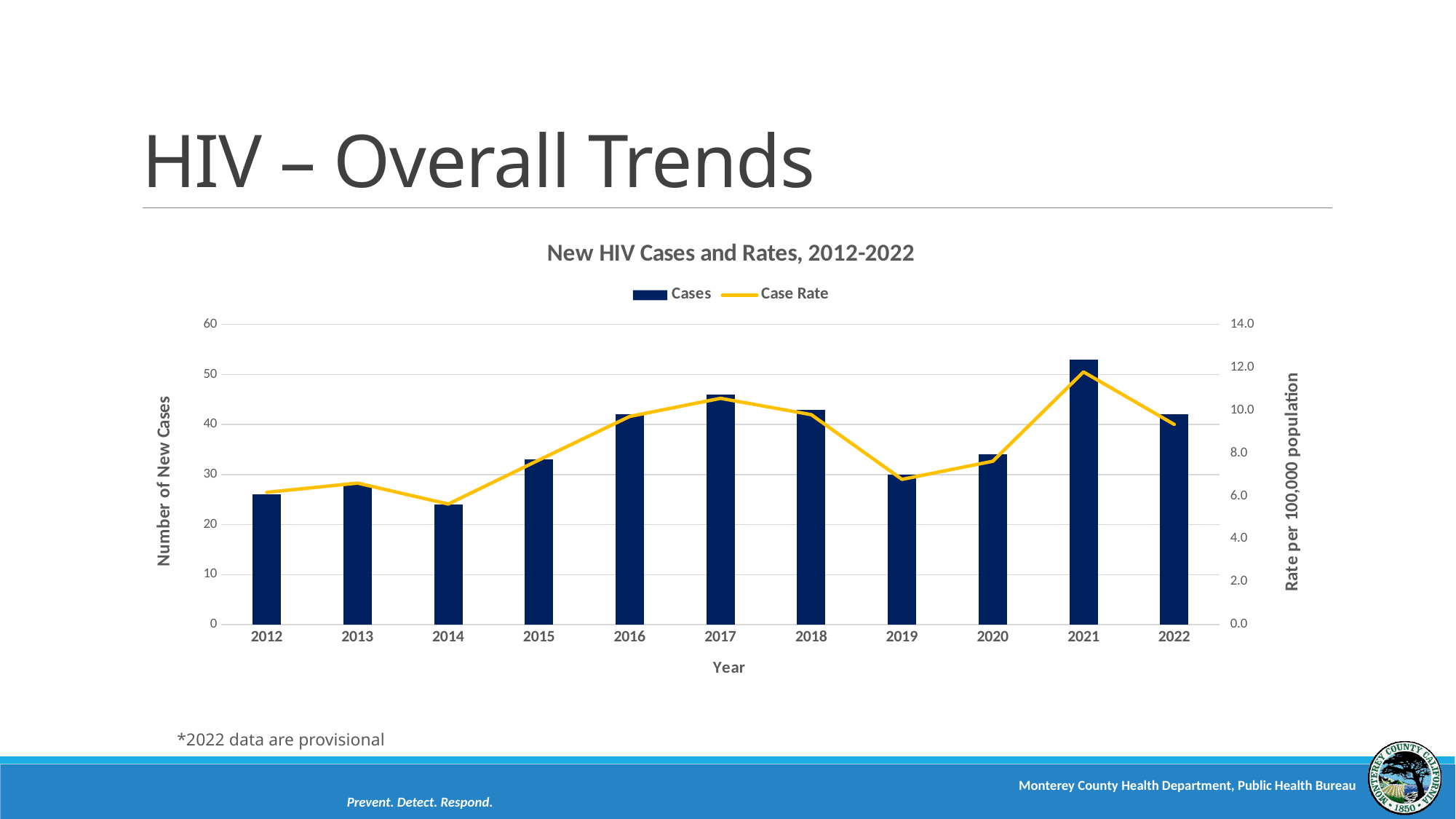
Which year has the lowest number of new cases? 2014 Is the number of new cases in 2017 greater or less than 40? greater Which year had more new cases, 2017 or 2015? 2017 How many series does the legend list? 2 Which year has the highest number of new cases? 2021 Which year had more new cases, 2019 or 2021? 2021 How many years are shown on the x axis? 11 Is the number of new cases in 2021 greater or less than 50? greater Do the number of new cases rise or fall from 2014 to 2017? rise Is the number of new cases in 2014 greater or less than 30? less What is the title of the chart? New HIV Cases and Rates, 2012-2022 What is the label of the right-hand vertical axis? Rate per 100,000 population